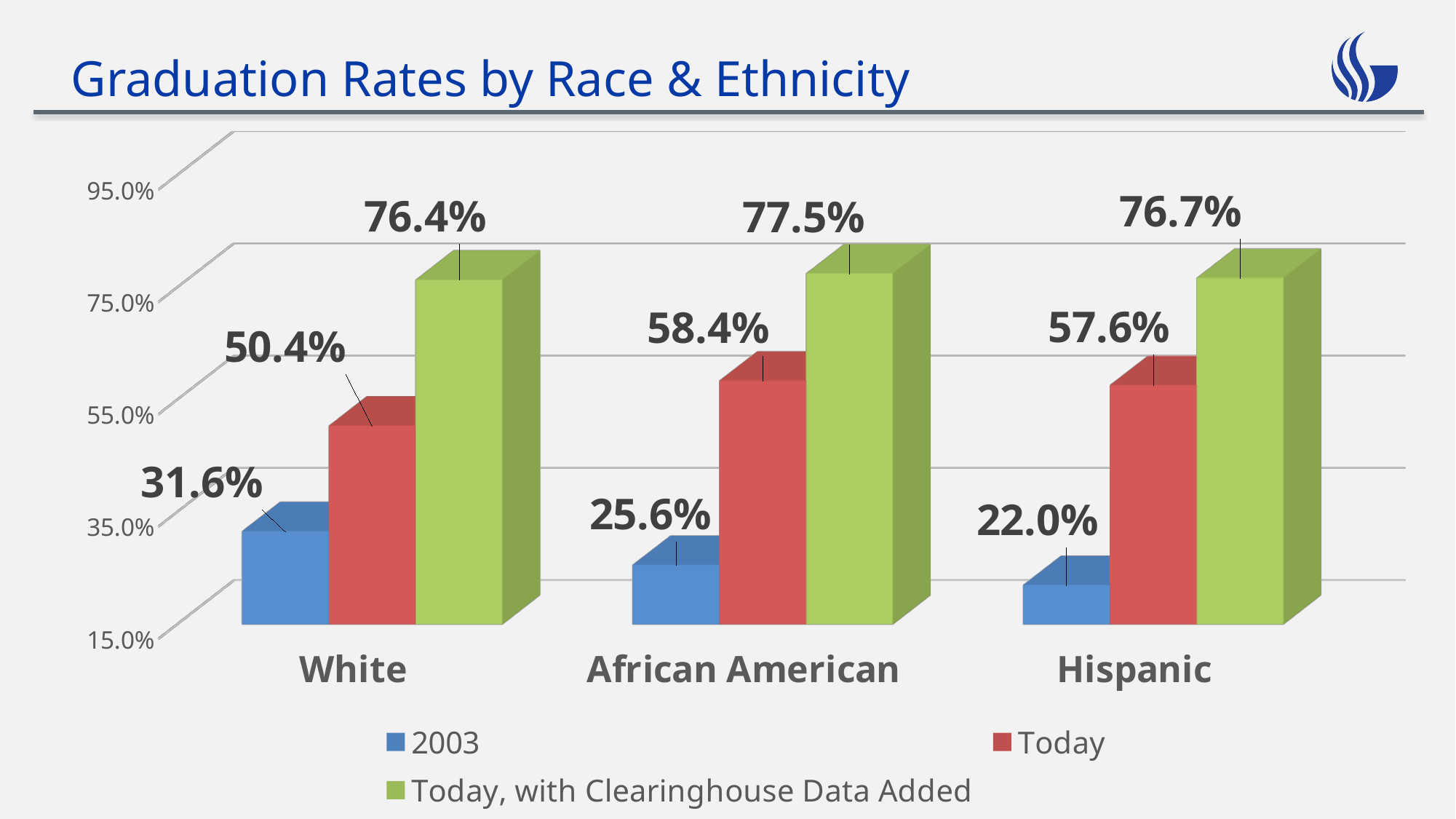
Which race/ethnicity group has the highest value in the 'Today, with Clearinghouse Data Added' series? African American What is the 2003 graduation rate for White students? 31.6% Which colour represents the 2003 series in the legend? Blue How many series does the legend list? 3 Which is larger: the Today rate for White students or the Today rate for African American students? African American What is the Today graduation rate for African American students? 58.4% What is the graduation rate for Hispanic students in the 'Today, with Clearinghouse Data Added' series? 76.7% How many race/ethnicity categories are shown on the x axis? 3 What is the title of the chart on the slide? Graduation Rates by Race & Ethnicity Which race/ethnicity group has the lowest 2003 graduation rate? Hispanic What kind of chart is shown on the slide? Bar chart What is the difference between the Today rate and the 2003 rate for Hispanic students? 35.6%